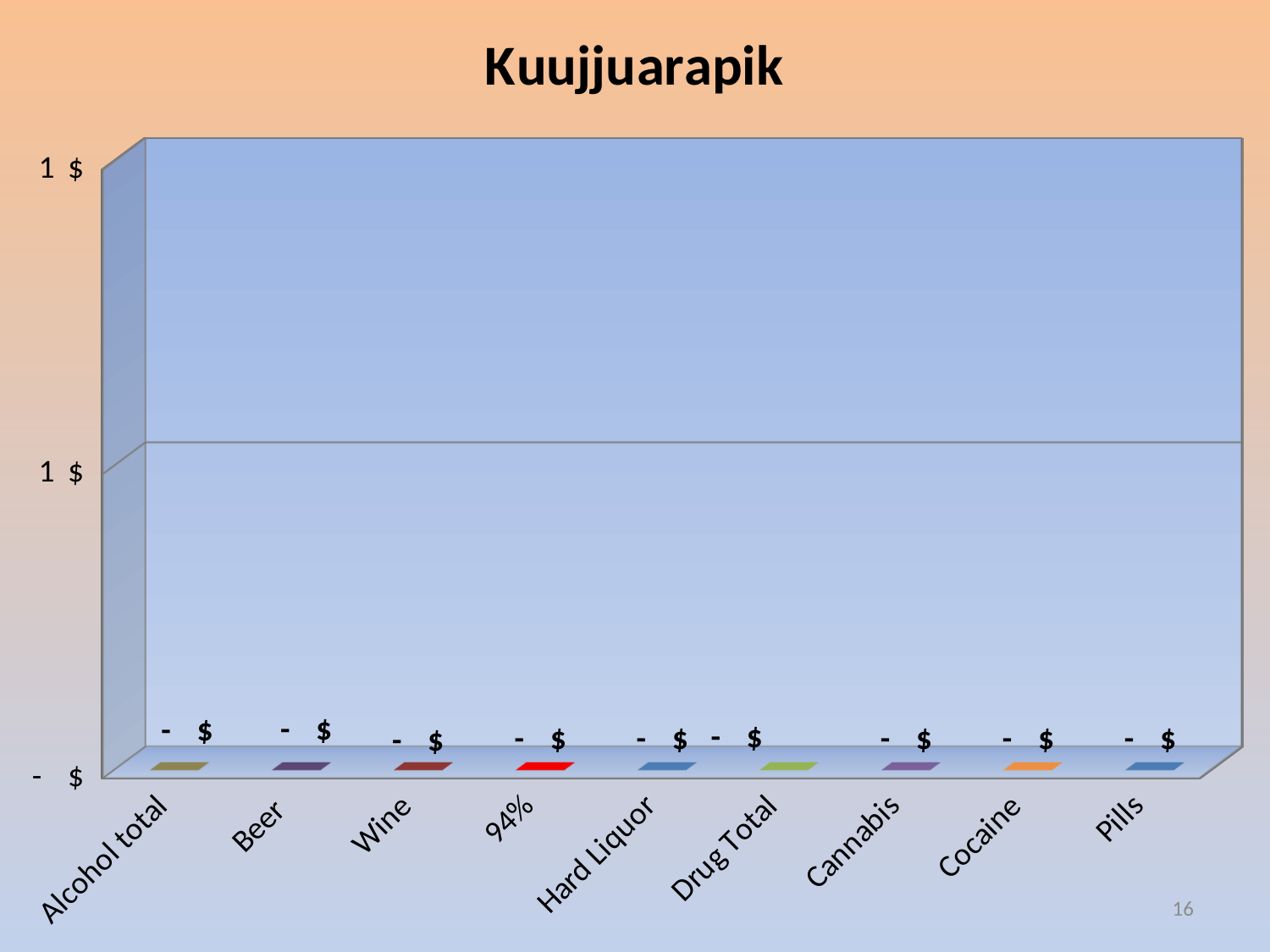
What value is labelled for Pills? - $ How many categories are shown on the x axis of the chart? 9 What value is labelled for Beer? - $ What value is labelled for Alcohol total? - $ What is the label of the first category on the x axis? Alcohol total What value is labelled for Drug Total? - $ What kind of chart is shown on the slide? bar chart Do the labelled values rise, fall, or stay the same across the categories from left to right? stay the same What value is labelled for Cannabis? - $ What is the title of the chart? Kuujjuarapik